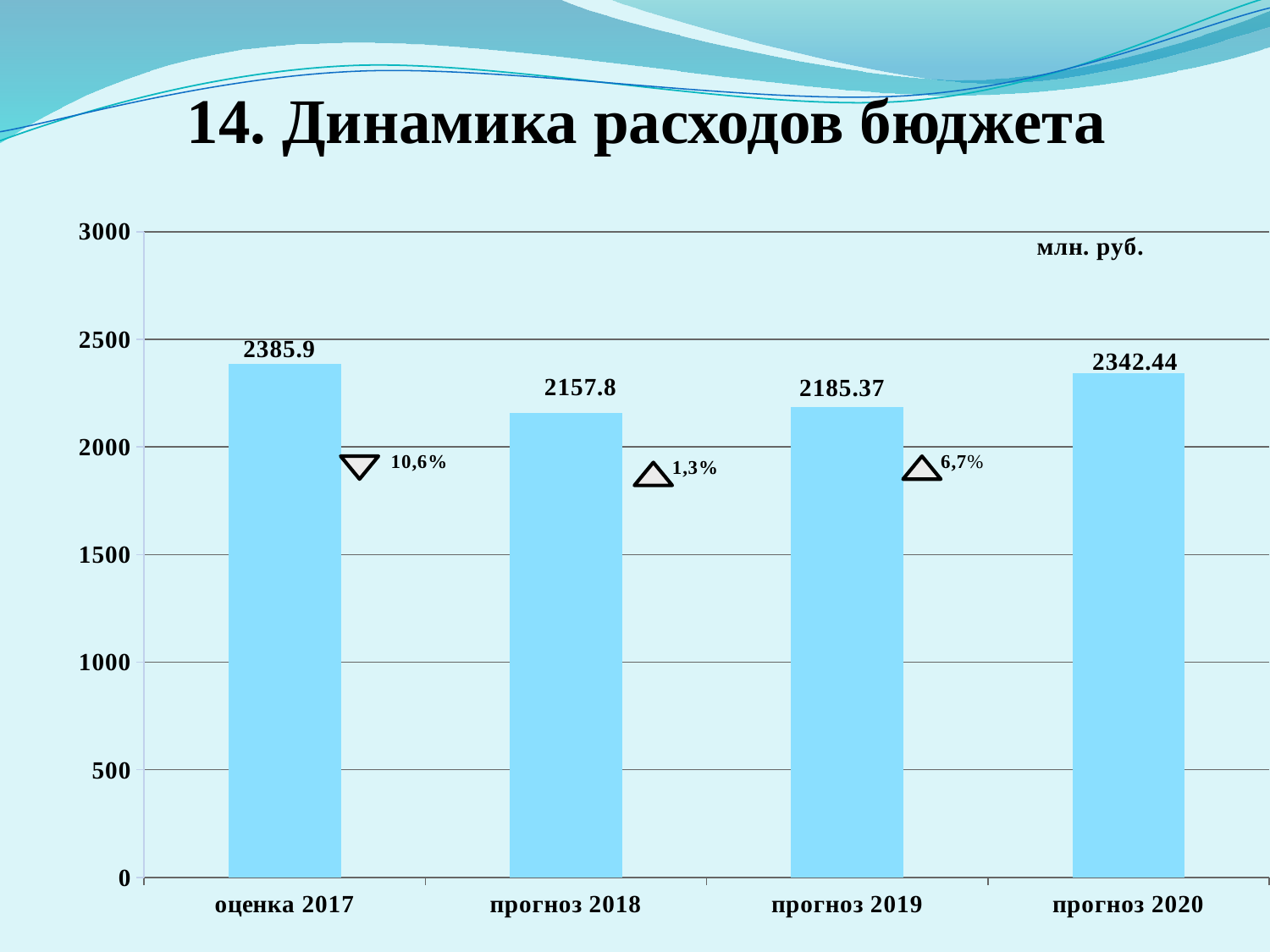
What is the difference between the values for оценка 2017 and прогноз 2018? 228.1 Which category has the highest value? оценка 2017 Which category has the lowest value? прогноз 2018 What is the value for оценка 2017? 2385.9 What is the value for прогноз 2019? 2185.37 How many categories are shown on the x axis? 4 Which is larger, the value for прогноз 2020 or the value for прогноз 2019? прогноз 2020 What kind of chart is shown on the slide? bar chart What is the value for прогноз 2018? 2157.8 What unit is indicated on the chart? млн. руб. Is the value for прогноз 2018 greater or less than 2500? less What is the value for прогноз 2020? 2342.44